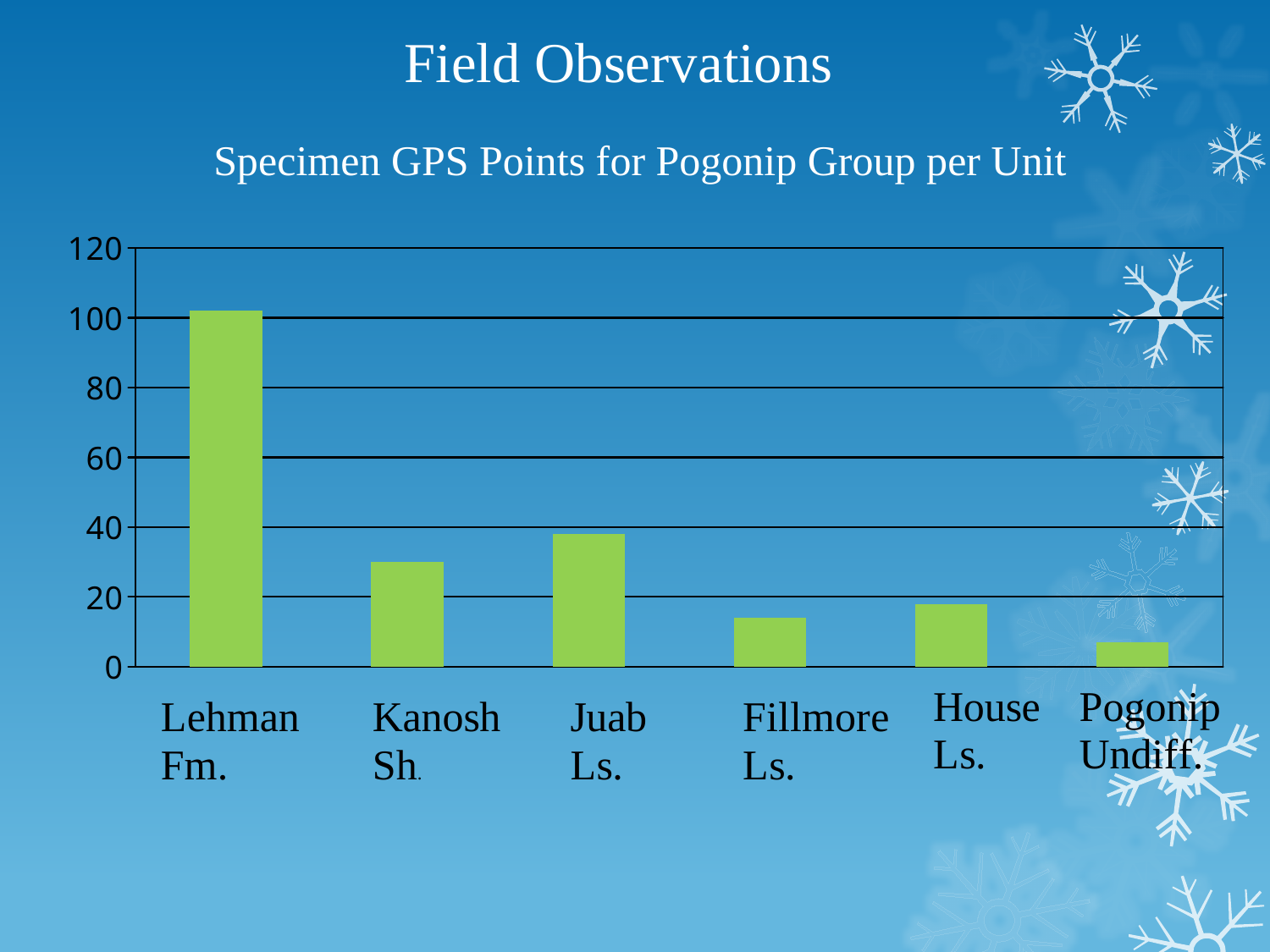
Is the value for Kanosh Sh. greater or less than 40? less What is the title of the chart? Specimen GPS Points for Pogonip Group per Unit What kind of chart is shown on the slide? bar chart How many units (categories) are plotted on the chart? 6 Which has more specimen GPS points, Lehman Fm. or Juab Ls.? Lehman Fm. Which unit has the lowest number of specimen GPS points? Pogonip Undiff. Is the value for Juab Ls. greater or less than 20? greater Is the value for Lehman Fm. greater or less than 80? greater Which has more specimen GPS points, Juab Ls. or Kanosh Sh.? Juab Ls. Which unit has the highest number of specimen GPS points? Lehman Fm.